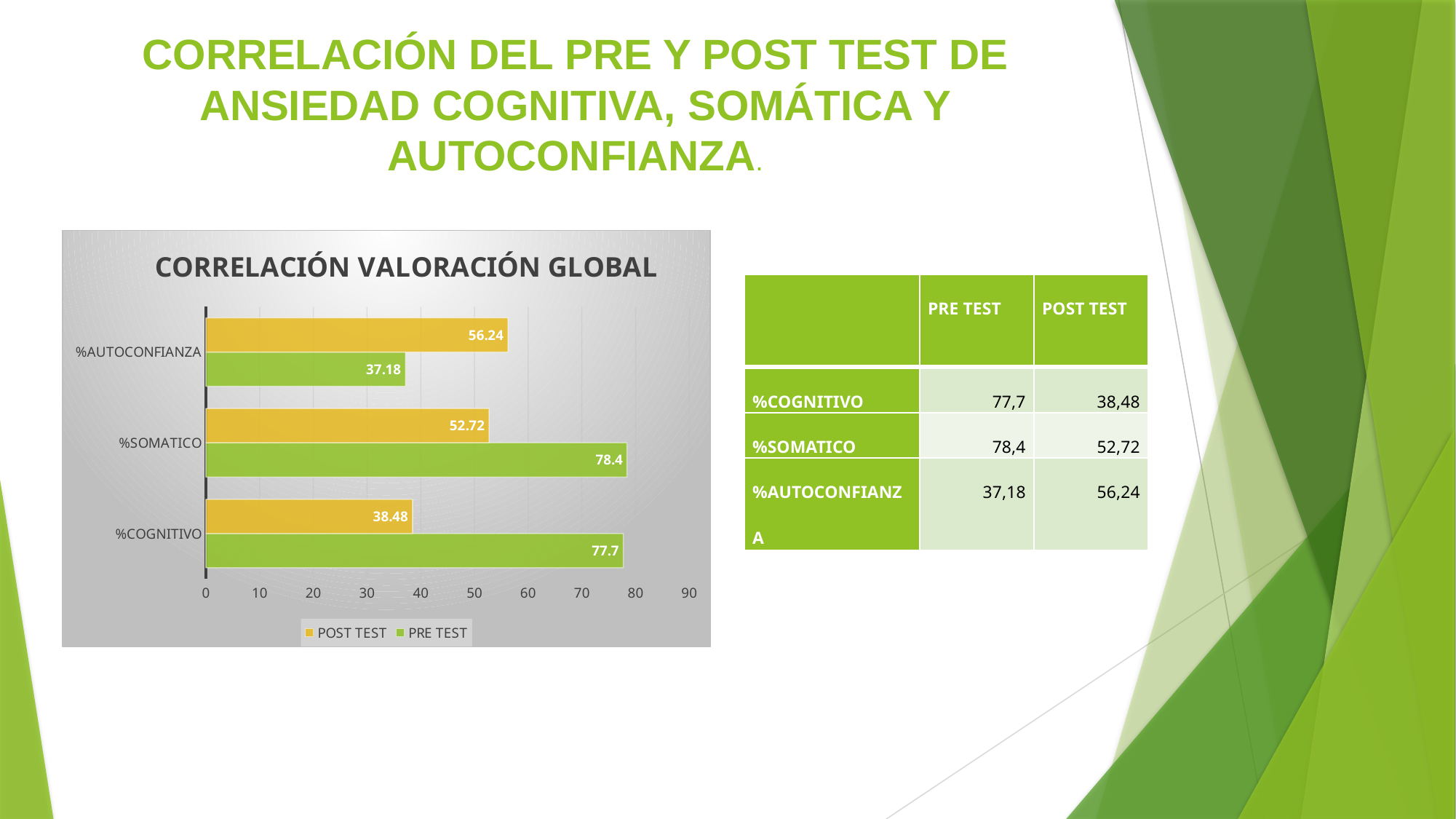
Which category has the lowest POST TEST value in the chart? %COGNITIVO What is the PRE TEST value for %COGNITIVO in the chart? 77.7 What is the difference between the PRE TEST and POST TEST values for %COGNITIVO? 39.22 What is the POST TEST value for %AUTOCONFIANZA in the chart? 56.24 What kind of chart is shown on the slide? Bar chart For %AUTOCONFIANZA, which is larger: the PRE TEST value or the POST TEST value? POST TEST What is the POST TEST value for %SOMATICO in the chart? 52.72 What is the PRE TEST value for %SOMATICO in the chart? 78.4 What is the title of the chart? CORRELACIÓN VALORACIÓN GLOBAL How many series does the chart legend list? 2 Which category has the highest PRE TEST value in the chart? %SOMATICO How many categories are shown in the chart? 3